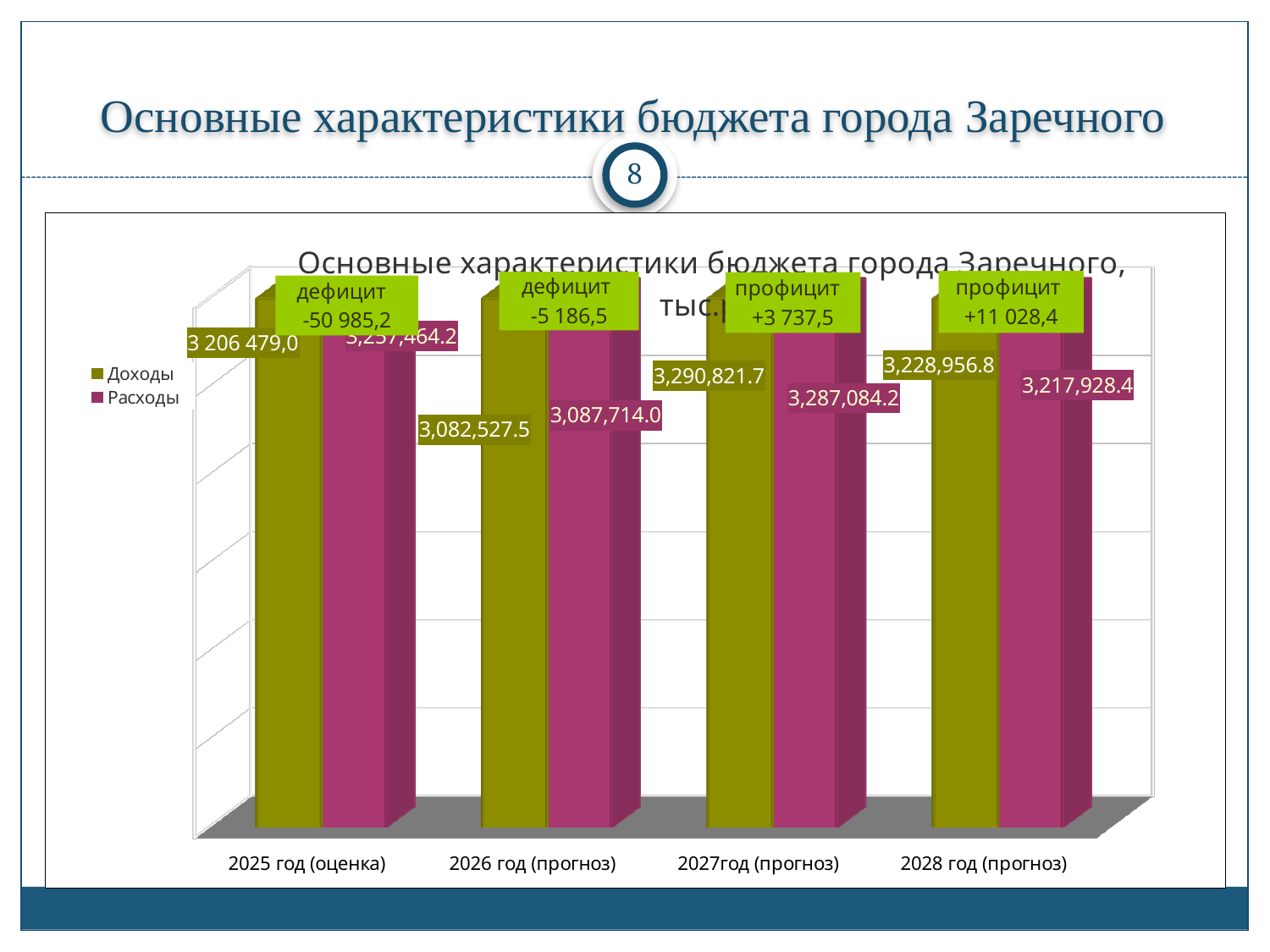
What is the value of Доходы for 2025 год (оценка)? 3 206 479,0 By how much do Расходы exceed Доходы in 2026 год (прогноз)? 5,186.5 What is the value of Расходы for 2026 год (прогноз)? 3,087,714.0 Which year has the highest value of Доходы? 2027год (прогноз) What is the value of Расходы for 2027год (прогноз)? 3,287,084.2 How many year categories are shown on the x axis? 4 What is the value of Доходы for 2026 год (прогноз)? 3,082,527.5 For 2028 год (прогноз), which is larger: Доходы or Расходы? Доходы Which year has the lowest value of Доходы? 2026 год (прогноз) What kind of chart is shown on the slide? Bar chart What is the value of Доходы for 2028 год (прогноз)? 3,228,956.8 How many series does the legend list? 2